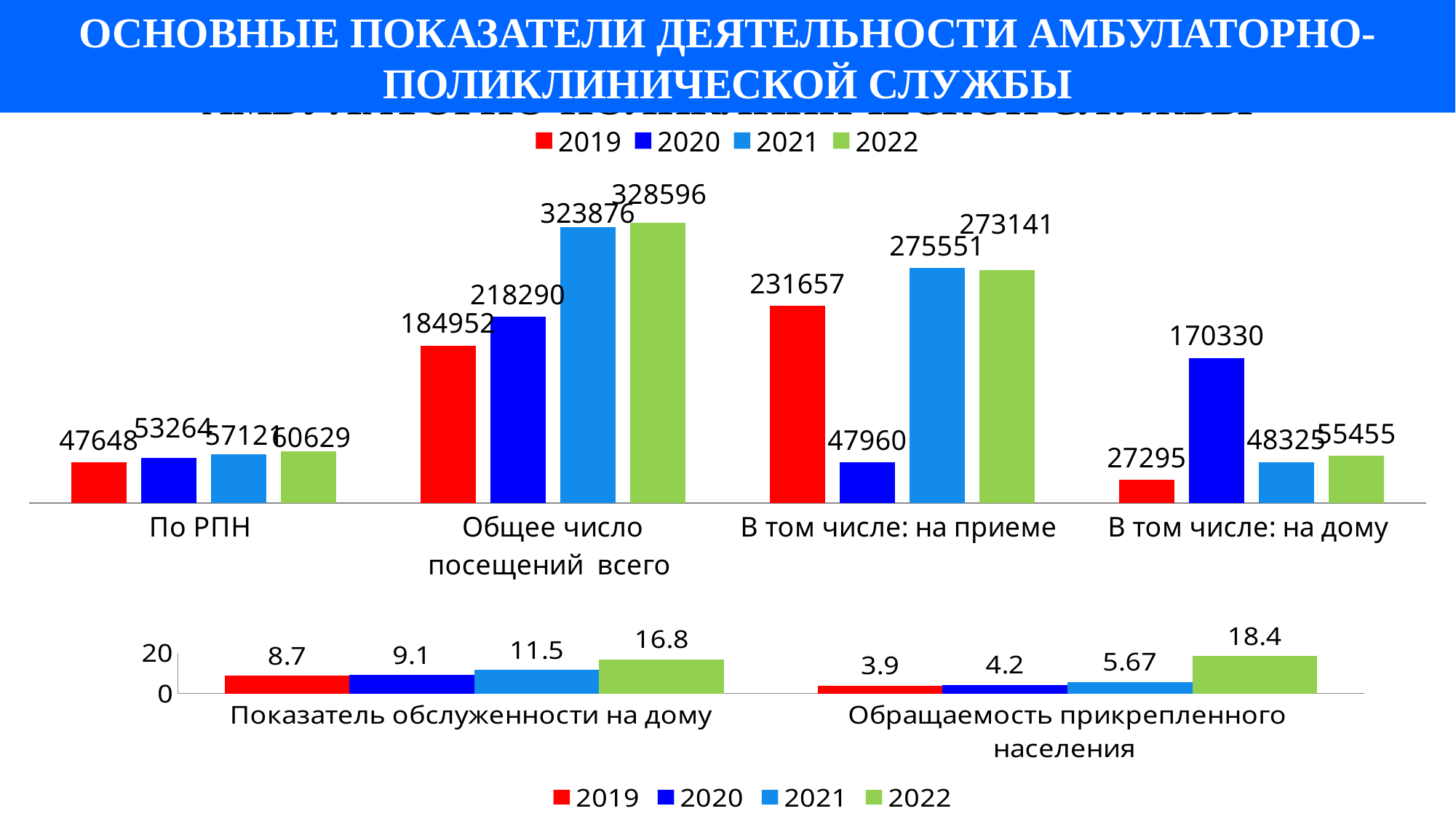
In the bottom chart, do the values for 'Показатель обслуженности на дому' rise or fall from 2019 to 2022? rise In the top chart, what is the 2020 value for 'В том числе: на дому'? 170330 In the top chart, what is the 2019 value for 'По РПН'? 47648 In the top chart, what is the difference between the 2021 and 2019 values for 'Общее число посещений всего'? 138924 In the top chart, which year has the lowest value for 'В том числе: на приеме'? 2020 What kind of chart is the bottom chart? bar chart In the bottom chart, what is the 2021 value for 'Показатель обслуженности на дому'? 11.5 In the top chart, how many series does the legend list? 4 In the bottom chart, what is the 2022 value for 'Обращаемость прикрепленного населения'? 18.4 In the top chart, what is the 2019 value for 'В том числе: на приеме'? 231657 In the top chart, which year has the highest value for 'Общее число посещений всего'? 2022 In the top chart, what is the 2022 value for 'Общее число посещений всего'? 328596